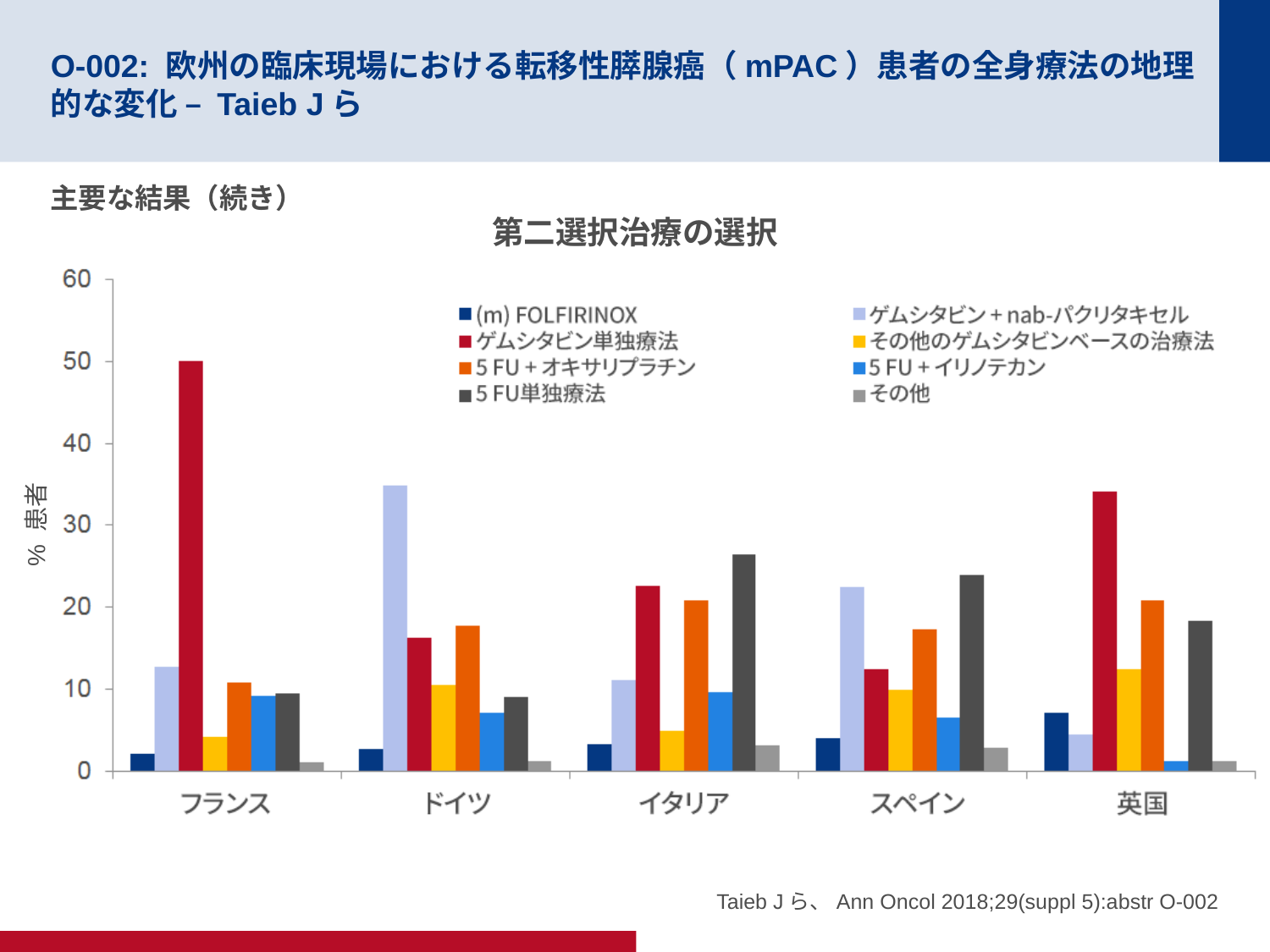
What is the title of the chart? 第二選択治療の選択 Is the value for ゲムシタビン + nab-パクリタキセル in ドイツ greater or less than 30? greater Which treatment has the highest value for フランス? ゲムシタビン単独療法 Is the value for ゲムシタビン単独療法 in フランス greater or less than 40? greater How many countries are shown on the x axis of the chart? 5 Which treatment has the highest value for ドイツ? ゲムシタビン + nab-パクリタキセル Which country has the highest value for ゲムシタビン単独療法? フランス Is the value for 5 FU単独療法 in イタリア greater or less than 20? greater How many series does the chart's legend list? 8 What kind of chart is shown on the slide? Bar chart Which is larger: the value for ゲムシタビン単独療法 in スペイン or in 英国? 英国